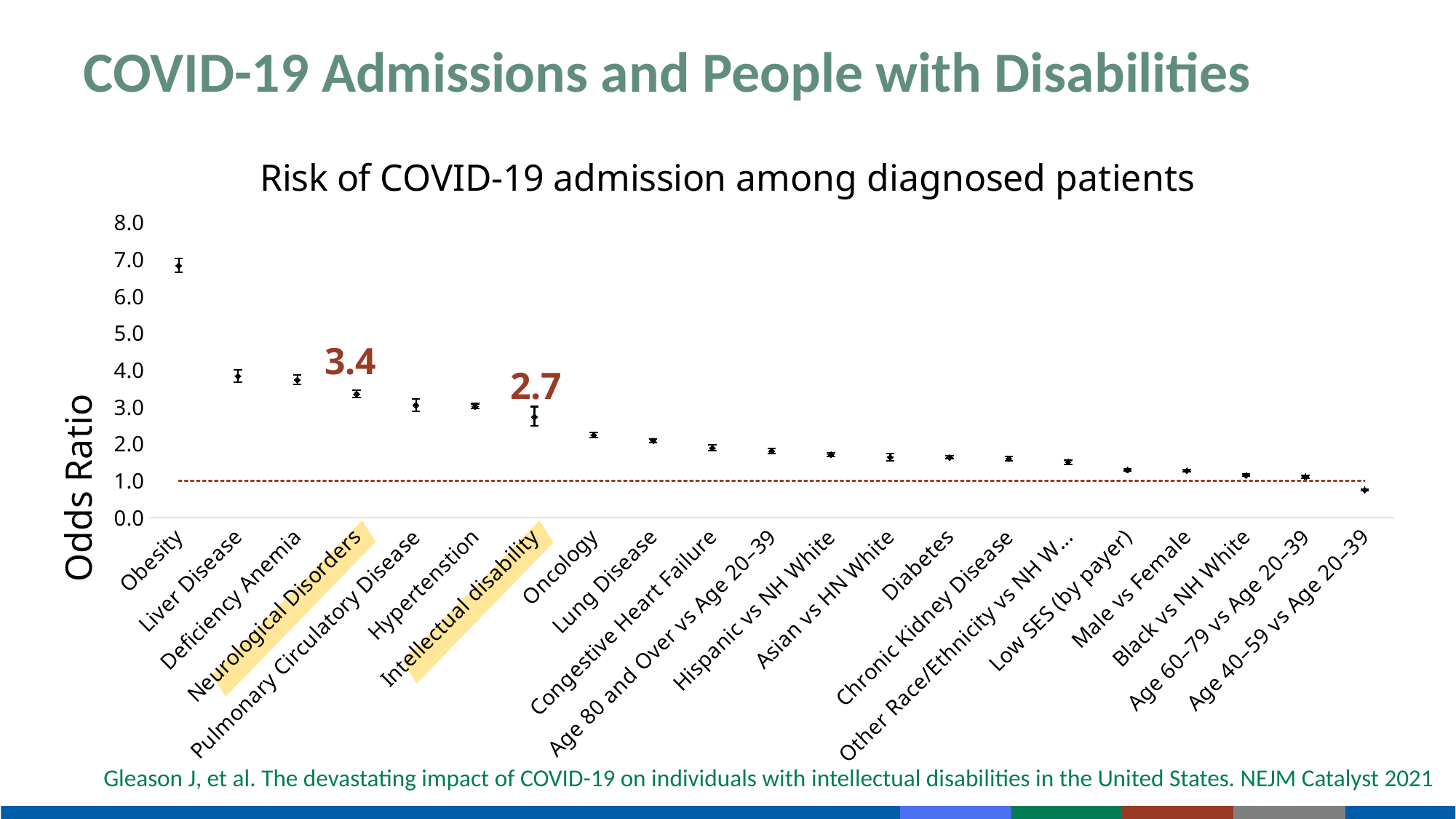
Is the odds ratio for Age 40–59 vs Age 20–39 greater or less than 1.0? less Which category has the lowest odds ratio? Age 40–59 vs Age 20–39 What is the odds ratio shown for Neurological Disorders? 3.4 How many categories are plotted on the x axis? 21 What is the label on the y axis of the chart? Odds Ratio Do the odds ratios generally rise or fall from left to right along the x axis? fall Which has a larger odds ratio, Neurological Disorders or Intellectual disability? Neurological Disorders What is the difference between the odds ratios for Neurological Disorders and Intellectual disability? 0.7 What is the odds ratio shown for Intellectual disability? 2.7 Which category has the highest odds ratio? Obesity Is the odds ratio for Oncology greater or less than 3.0? less Is the odds ratio for Obesity greater or less than 6.0? greater